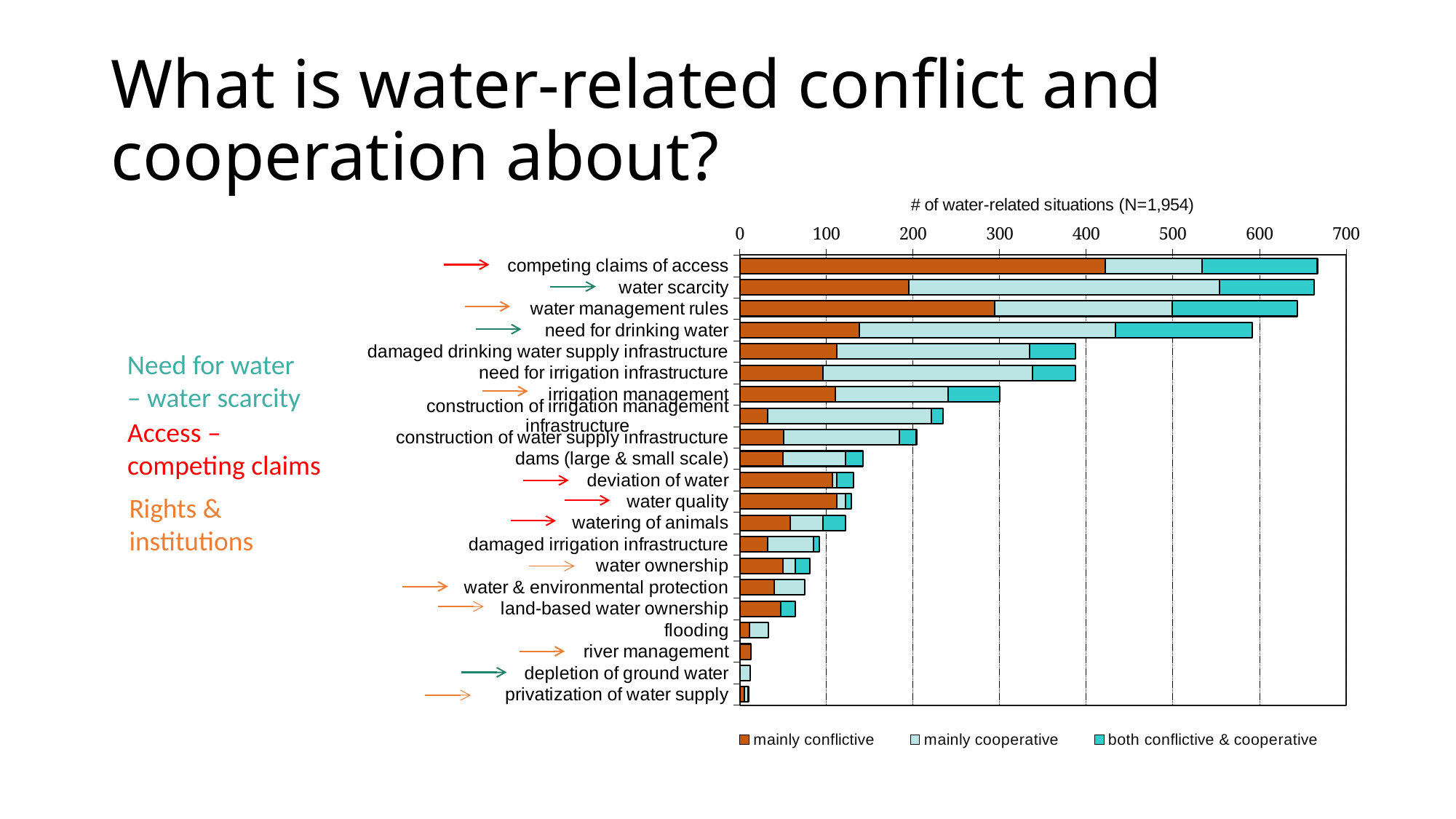
How many series does the chart's legend list? 3 Is the total bar length for 'damaged drinking water supply infrastructure' greater or less than 300? greater Which legend entry is shown in dark orange? mainly conflictive How many categories are plotted on the chart? 21 Is the total bar length for 'flooding' greater or less than 100? less Which has a larger 'mainly conflictive' segment: 'water management rules' or 'water scarcity'? water management rules Which category has the largest 'mainly conflictive' segment? competing claims of access Which has a longer total bar: 'water management rules' or 'need for drinking water'? water management rules What kind of chart is shown on the slide? bar chart Is the 'mainly conflictive' value for 'competing claims of access' greater or less than 300? greater What is the title of the chart? # of water-related situations (N=1,954)